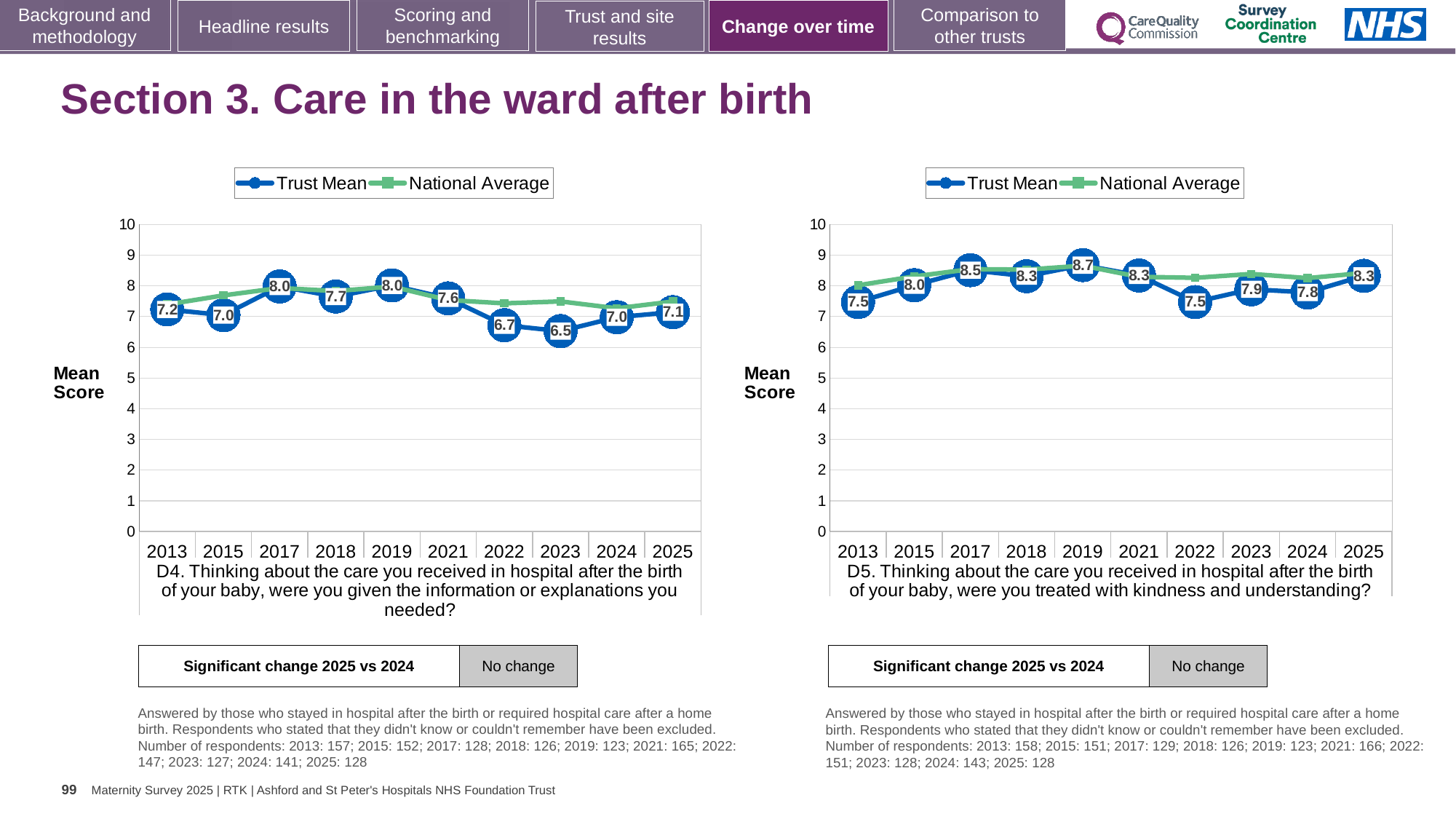
On the D4 chart (left), which year has the lowest Trust Mean score? 2023 On the D5 chart (right), which year has the highest Trust Mean score? 2019 On the D4 chart (left), what is the difference between the Trust Mean scores for 2019 and 2023? 1.5 On the D5 chart (right), which is larger, the Trust Mean score for 2021 or for 2022? 2021 On the D4 chart (left), what is the Trust Mean score for 2023? 6.5 On the D5 chart (right), what is the Trust Mean score for 2019? 8.7 How many series does the legend of the D4 chart (left) list? 2 What type of chart is the D4 chart (left)? Line chart On the D4 chart (left), what is the Trust Mean score for 2025? 7.1 How many years are plotted on the D5 chart (right)? 10 On the D4 chart (left), is the Trust Mean score for 2022 greater or less than 7? less On the D5 chart (right), what is the difference between the Trust Mean scores for 2025 and 2024? 0.5